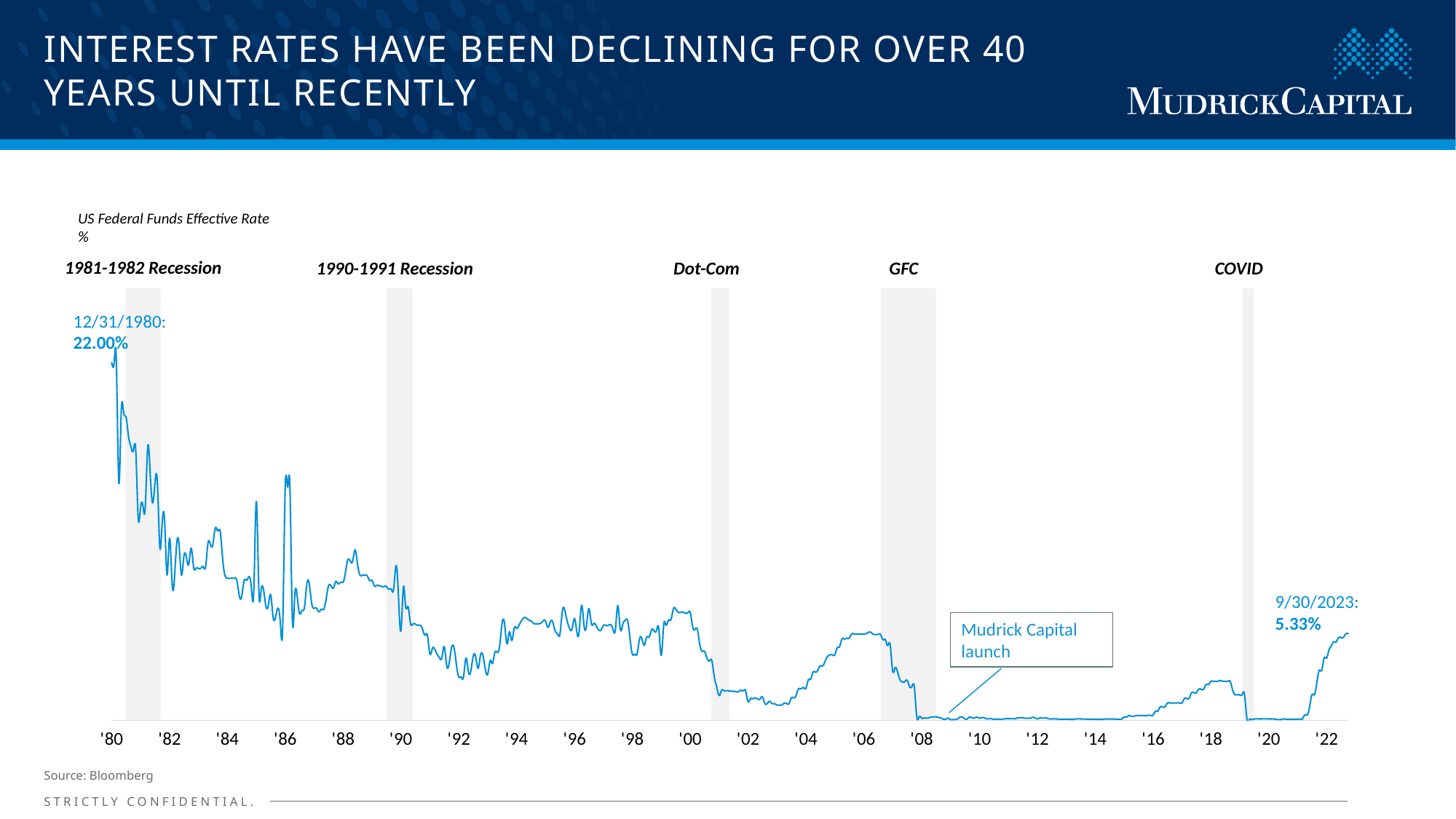
Between 2021 and 2023, does the US Federal Funds Effective Rate rise or fall? Rise How many shaded event periods are marked on the chart? 5 Which labelled value is larger, the rate on 12/31/1980 or the rate on 9/30/2023? 12/31/1980 Over the full period from 1980 to 2023, does the US Federal Funds Effective Rate generally rise or fall? Fall What is the first year shown on the x axis of the chart? '80 What is the value of the US Federal Funds Effective Rate labelled for 12/31/1980? 22.00% What is the difference between the labelled rate on 12/31/1980 and the labelled rate on 9/30/2023? 16.67% What is the value of the US Federal Funds Effective Rate labelled for 9/30/2023? 5.33% What event is annotated on the chart around 2009? Mudrick Capital launch What kind of chart is shown on the slide? Line chart